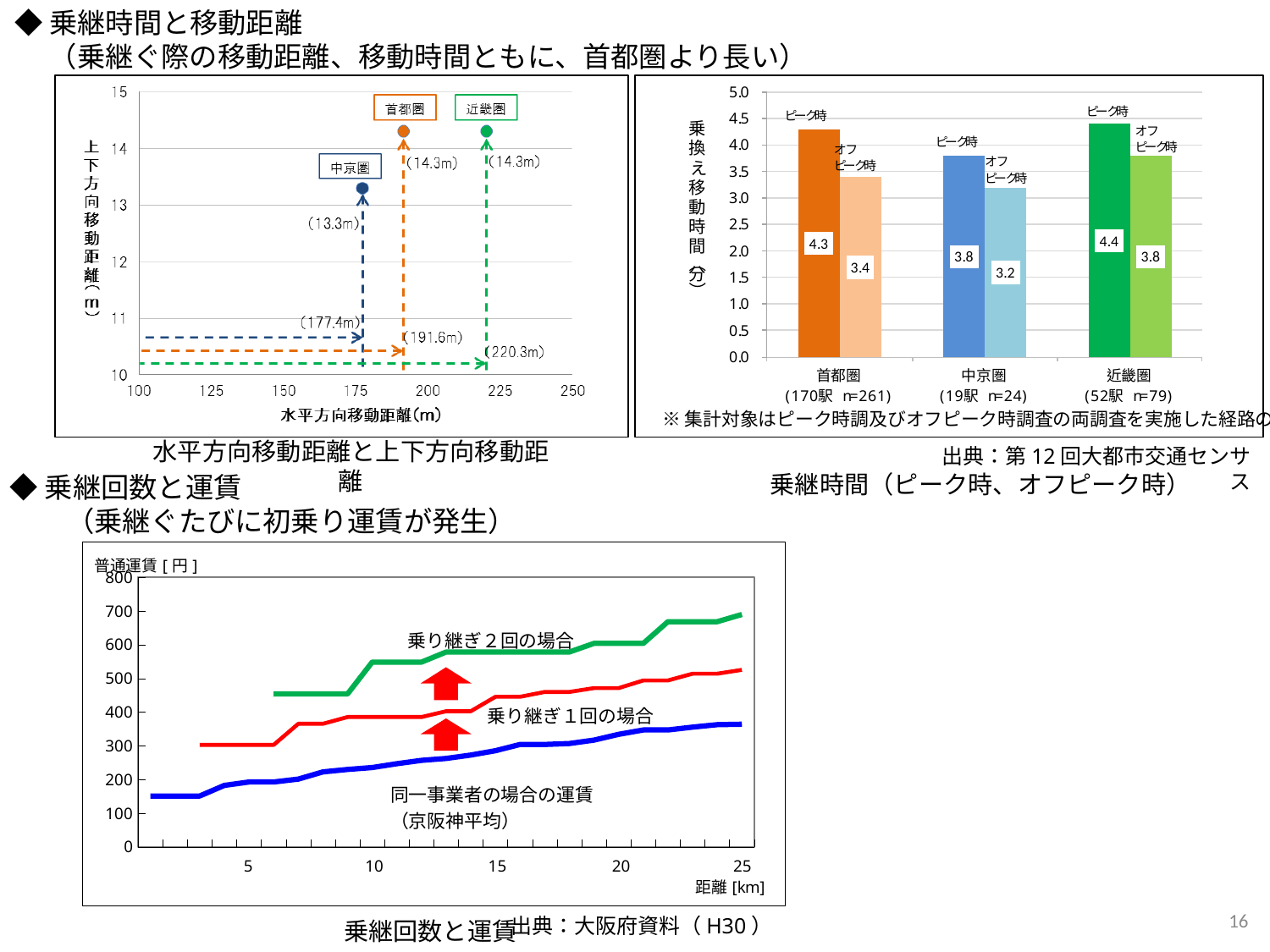
In the top-left chart (水平方向移動距離と上下方向移動距離), what is the vertical movement distance for 中京圏? 13.3m What kind of chart is the top-right chart (乗継時間)? bar chart In the top-right bar chart (乗継時間), what is the off-peak (オフピーク時) transfer movement time for 中京圏? 3.2 In the bottom chart (乗継回数と運賃), how many fare lines are plotted? 3 In the top-right bar chart (乗継時間), how many regions are shown on the x axis? 3 In the top-right bar chart (乗継時間), which region has the highest peak-time (ピーク時) transfer movement time? 近畿圏 In the top-right bar chart (乗継時間), which region has the lowest off-peak (オフピーク時) transfer movement time? 中京圏 In the top-left chart (水平方向移動距離と上下方向移動距離), which region has the shortest horizontal movement distance? 中京圏 In the top-right bar chart (乗継時間), what is the peak-time (ピーク時) transfer movement time for 首都圏? 4.3 In the top-left chart (水平方向移動距離と上下方向移動距離), what is the horizontal movement distance for 近畿圏? 220.3m In the top-right bar chart (乗継時間), what is the difference between the peak-time and off-peak values for 近畿圏? 0.6 In the bottom chart (乗継回数と運賃), is the fare for 乗り継ぎ2回の場合 at 25 km greater or less than 600? greater